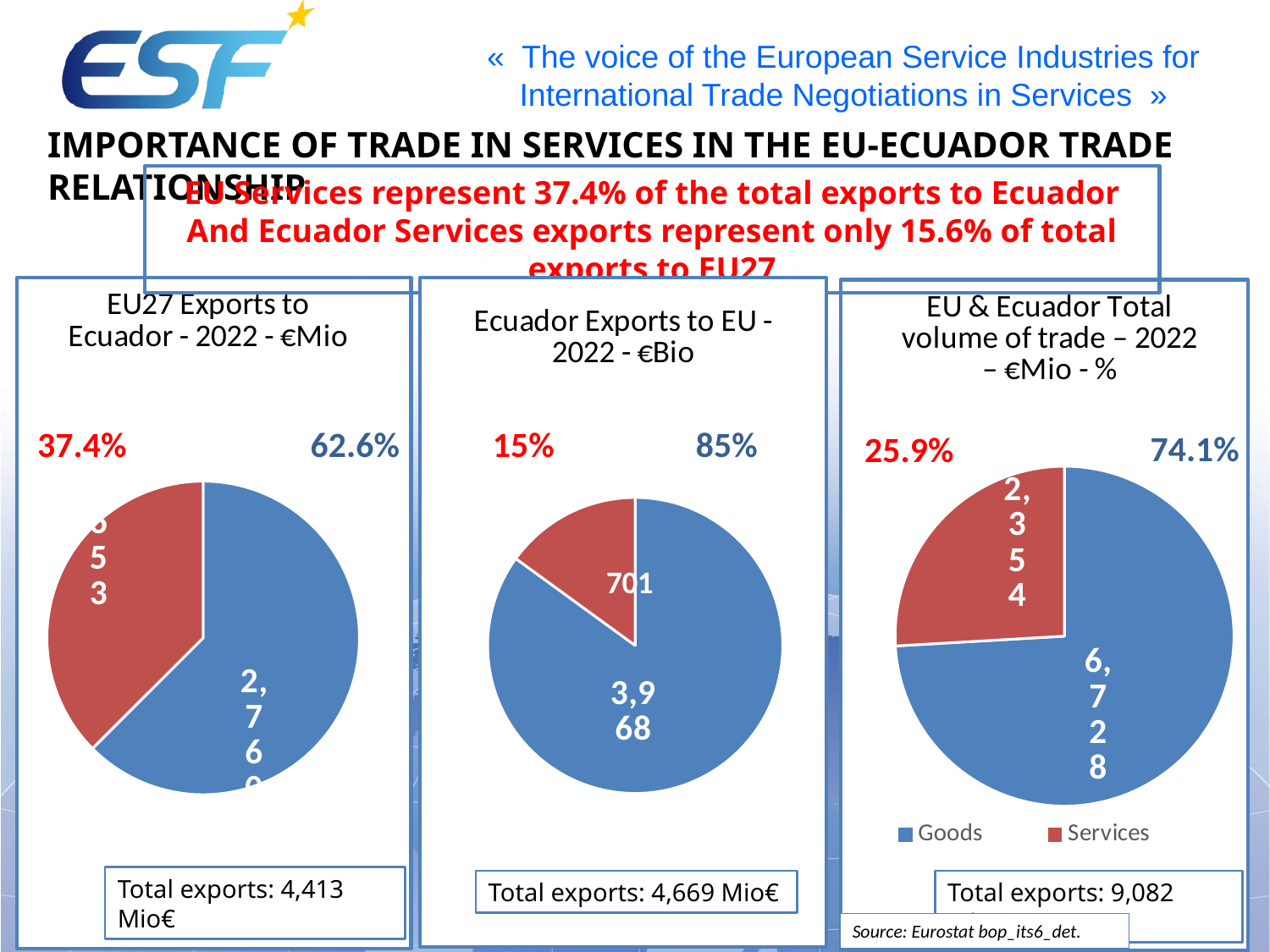
In the chart titled 'EU & Ecuador Total volume of trade – 2022 – €Mio - %', what percentage share does Services have? 25.9% In the chart titled 'EU & Ecuador Total volume of trade – 2022 – €Mio - %', what is the value shown for Goods? 6,728 In the chart titled 'Ecuador Exports to EU - 2022 - €Bio', what is the value shown on the red slice? 701 In the chart titled 'EU & Ecuador Total volume of trade – 2022 – €Mio - %', what percentage share does Goods have? 74.1% In the chart titled 'EU & Ecuador Total volume of trade – 2022 – €Mio - %', how many series does the legend list? 2 In the chart titled 'EU & Ecuador Total volume of trade – 2022 – €Mio - %', what is the difference between the Goods value and the Services value? 4,374 In the chart titled 'EU27 Exports to Ecuador - 2022 - €Mio', what percentage share does the red slice have? 37.4% In the chart titled 'Ecuador Exports to EU - 2022 - €Bio', what is the value shown on the blue slice? 3,968 In the chart titled 'EU & Ecuador Total volume of trade – 2022 – €Mio - %', what is the value shown for Services? 2,354 What kind of chart is the chart titled 'EU27 Exports to Ecuador - 2022 - €Mio'? Pie chart In the chart titled 'EU & Ecuador Total volume of trade – 2022 – €Mio - %', which is larger, Goods or Services? Goods